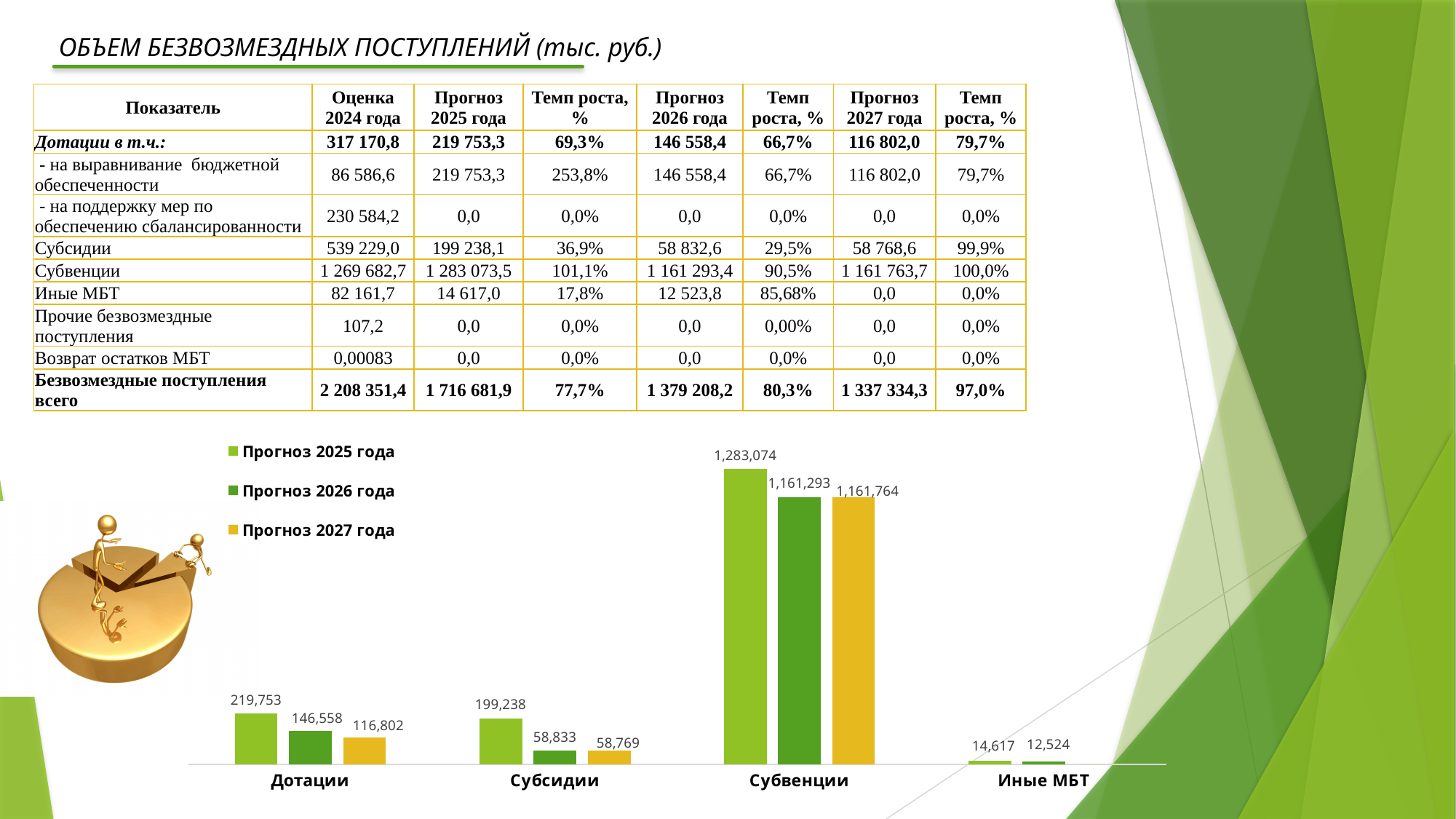
How many categories are shown on the x axis of the chart? 4 In the chart, what is the value for Иные МБТ in the Прогноз 2026 года series? 12,524 In the chart, what is the value for Дотации in the Прогноз 2027 года series? 116,802 How many series does the chart legend list? 3 What kind of chart is shown at the bottom of the slide? bar chart Which category has the highest bar in the chart? Субвенции In the chart, what is the difference between the Прогноз 2025 года and Прогноз 2026 года values for Дотации? 73,195 In the chart, what is the value for Субсидии in the Прогноз 2026 года series? 58,833 In the chart, which is larger for the Прогноз 2025 года series: Дотации or Субсидии? Дотации In the chart, do the values for Дотации rise or fall from Прогноз 2025 года to Прогноз 2027 года? fall Which category has the lowest bars in the chart? Иные МБТ In the chart, what is the value for Субвенции in the Прогноз 2025 года series? 1,283,074